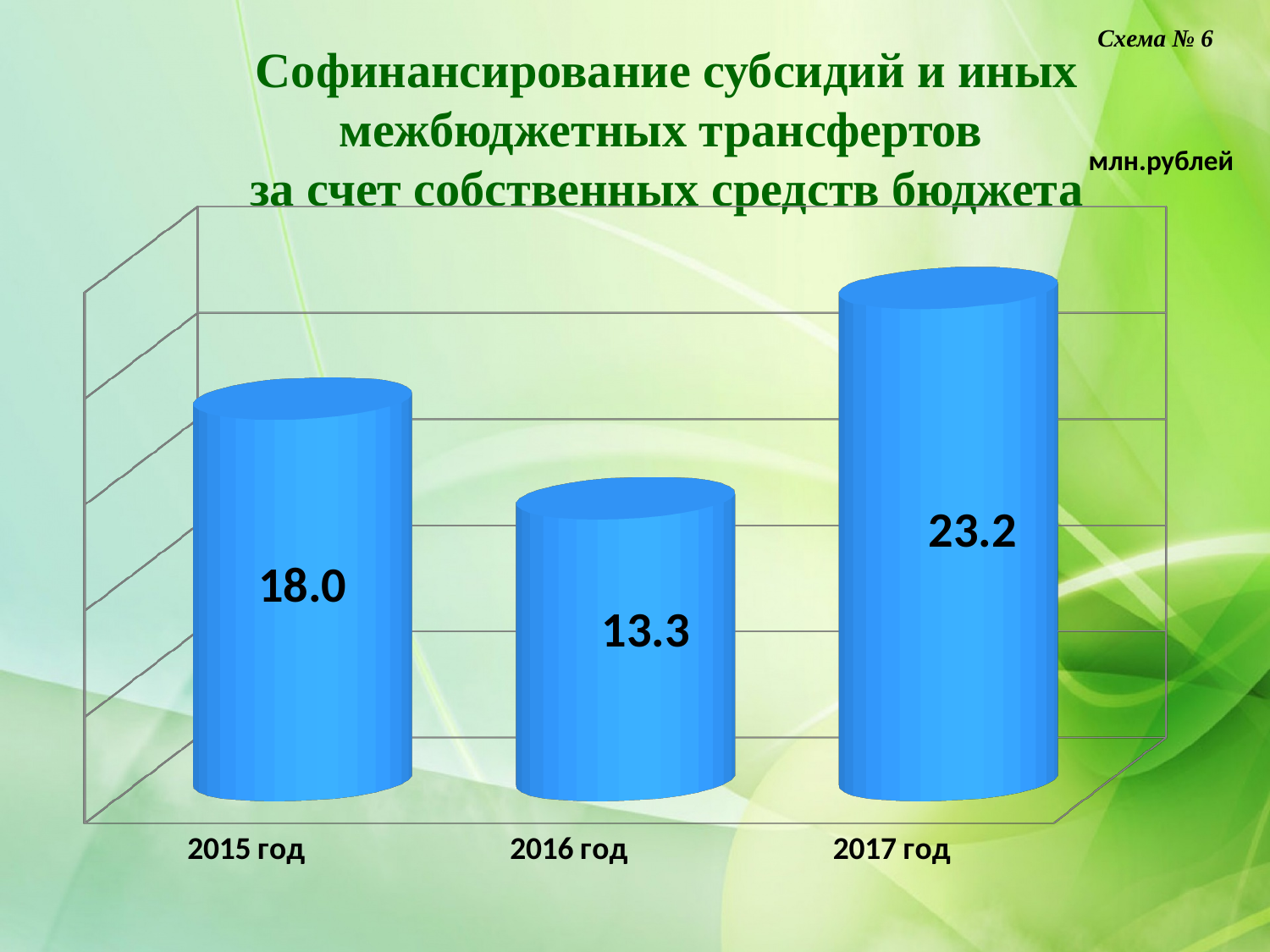
What is the value for 2016 год? 13.3 What is the difference between the values for 2015 год and 2016 год? 4.7 What is the value for 2015 год? 18.0 What is the difference between the values for 2017 год and 2016 год? 9.9 How many years are shown on the chart? 3 What unit is indicated for the values on the chart? млн.рублей Which is larger, the value for 2015 год or the value for 2017 год? 2017 год What kind of chart is shown on the slide? bar chart Which year has the highest value? 2017 год Does the value rise or fall from 2016 год to 2017 год? rise What is the value for 2017 год? 23.2 Which year has the lowest value? 2016 год